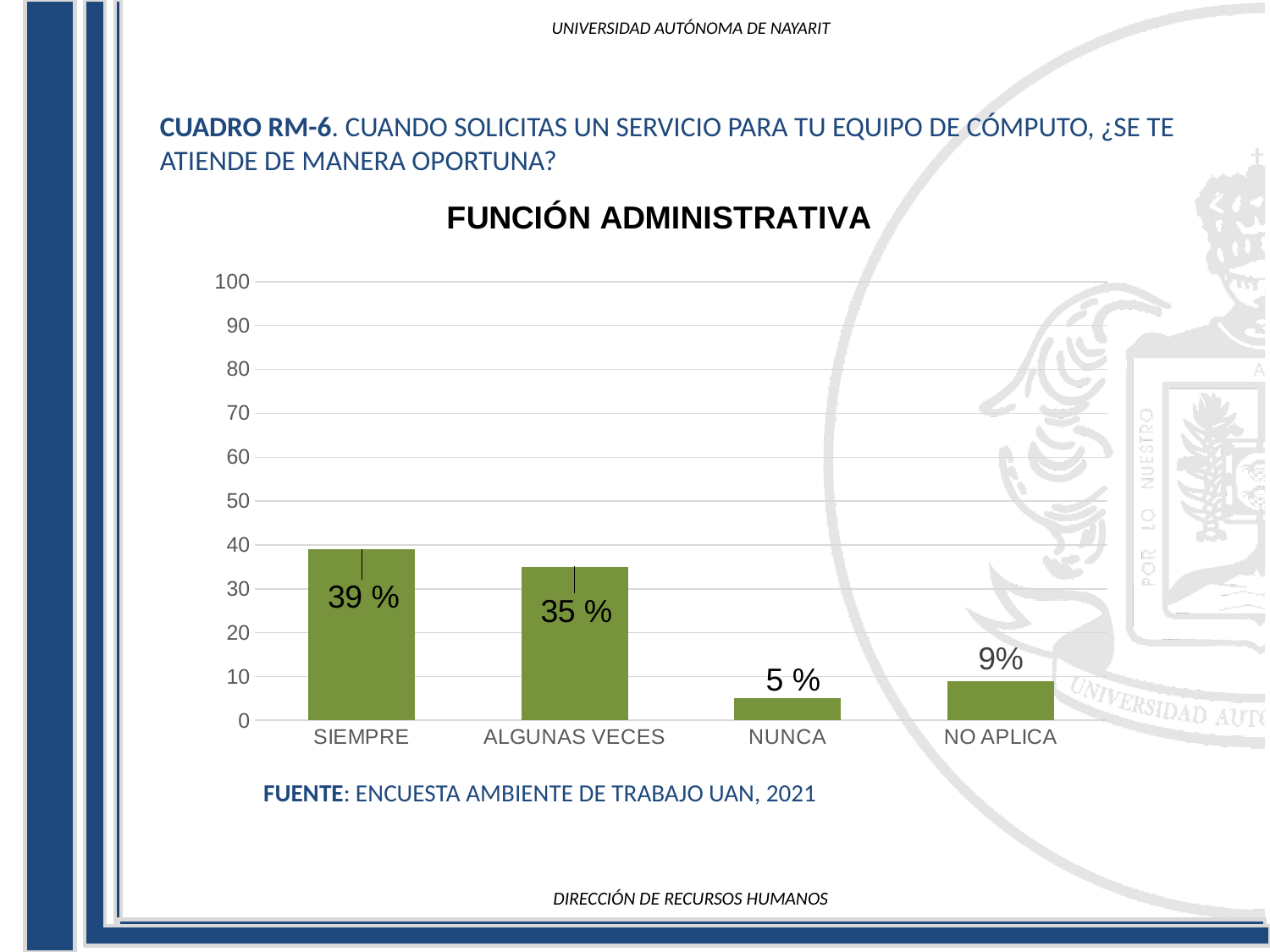
Which category has the lowest value? NUNCA What is the value for SIEMPRE? 39 % Which is larger, the value for NO APLICA or the value for NUNCA? NO APLICA What is the value for ALGUNAS VECES? 35 % What is the value for NO APLICA? 9% What is the difference between the values for SIEMPRE and ALGUNAS VECES? 4 % How many categories are shown on the x axis? 4 Which category has the highest value? SIEMPRE What is the value for NUNCA? 5 % What is the title of the chart? FUNCIÓN ADMINISTRATIVA Is the value for ALGUNAS VECES greater or less than 30? greater What kind of chart is shown? bar chart